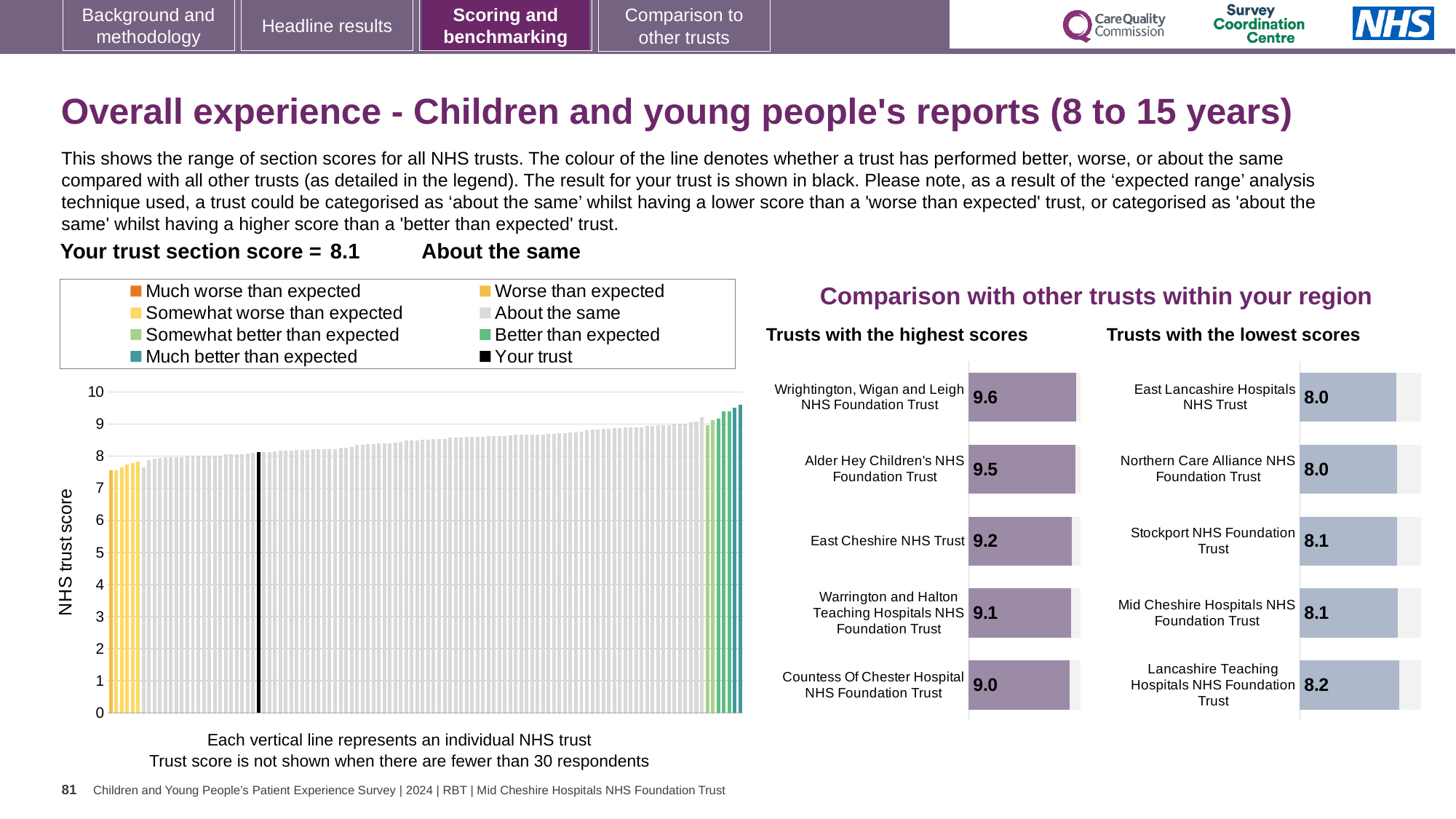
In the large chart on the left, what is the label of the vertical axis? NHS trust score In the 'Trusts with the highest scores' chart, how many trusts are shown? 5 In the 'Trusts with the lowest scores' chart, which trust has the highest score? Lancashire Teaching Hospitals NHS Foundation Trust In the 'Trusts with the highest scores' chart, what is the score for Wrightington, Wigan and Leigh NHS Foundation Trust? 9.6 In the 'Trusts with the highest scores' chart, what is the difference between the scores of Wrightington, Wigan and Leigh NHS Foundation Trust and Countess Of Chester Hospital NHS Foundation Trust? 0.6 In the 'Trusts with the highest scores' chart, what is the score for East Cheshire NHS Trust? 9.2 In the 'Trusts with the lowest scores' chart, what is the score for Lancashire Teaching Hospitals NHS Foundation Trust? 8.2 In the 'Trusts with the lowest scores' chart, what is the difference between the scores of Lancashire Teaching Hospitals NHS Foundation Trust and Northern Care Alliance NHS Foundation Trust? 0.2 What kind of chart is the large chart on the left showing all NHS trusts? Bar chart In the 'Trusts with the lowest scores' chart, which has the larger score: Stockport NHS Foundation Trust or East Lancashire Hospitals NHS Trust? Stockport NHS Foundation Trust In the 'Trusts with the highest scores' chart, which trust has the lowest score? Countess Of Chester Hospital NHS Foundation Trust In the large chart on the left, how many entries does the legend list? 8